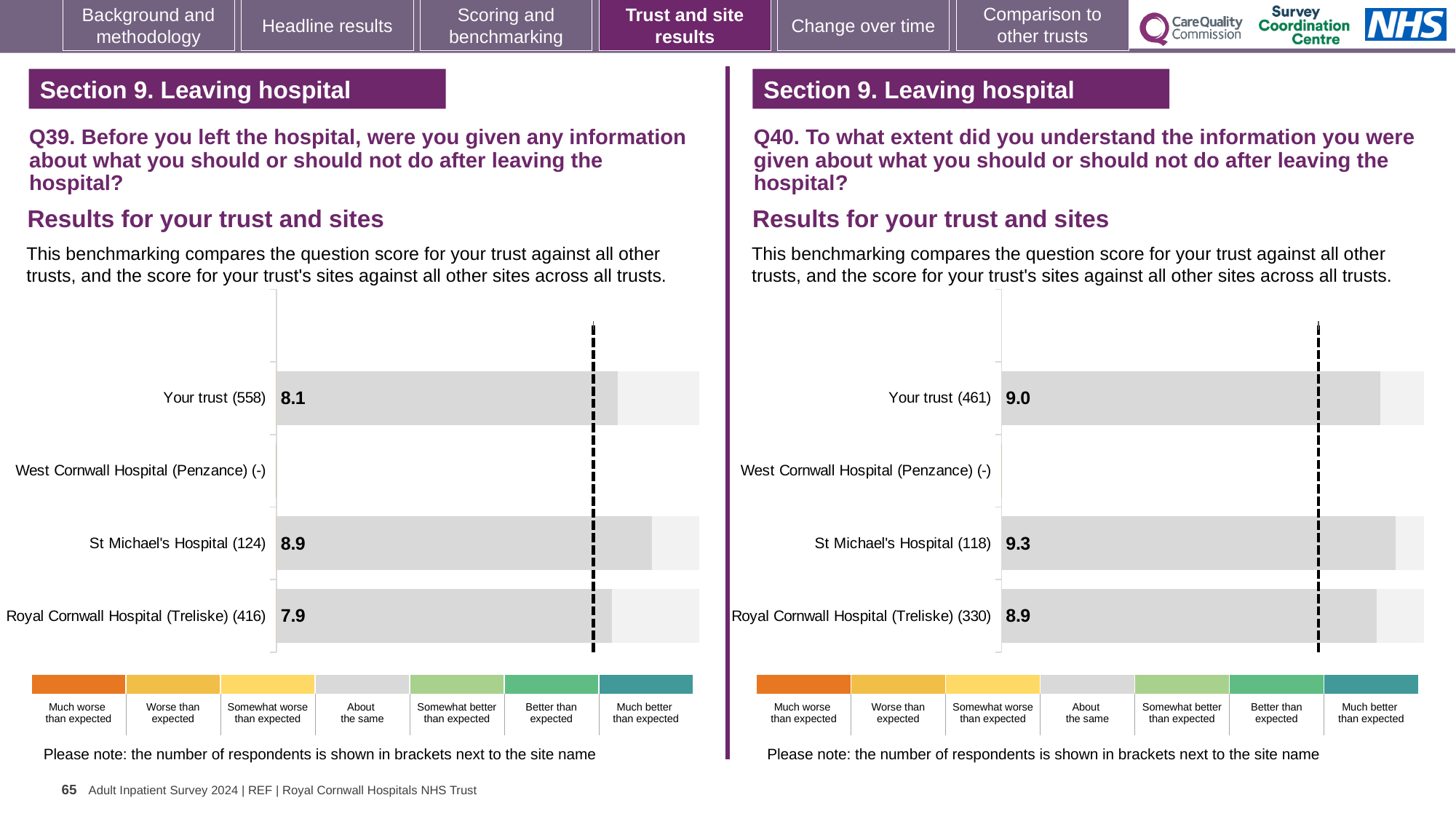
In the Q39 chart on the left, what is the score for Your trust? 8.1 How many rows (trust and sites) are listed on the y axis of the Q39 chart on the left? 4 In the Q39 chart on the left, what is the difference between the scores for St Michael's Hospital and Royal Cornwall Hospital (Treliske)? 1.0 In the Q40 chart on the right, which site or trust row has the highest score? St Michael's Hospital (118) In the Q40 chart on the right, which has the larger score: Your trust or Royal Cornwall Hospital (Treliske)? Your trust What kind of chart is used in the Q39 chart on the left? Bar chart In the Q40 chart on the right, what is the score for Your trust? 9.0 How many respondents are shown in brackets for Your trust in the Q40 chart on the right? 461 In the Q39 chart on the left, what is the score for Royal Cornwall Hospital (Treliske)? 7.9 In the Q40 chart on the right, what is the score for Royal Cornwall Hospital (Treliske)? 8.9 In the Q39 chart on the left, which row with a score shown has the lowest score? Royal Cornwall Hospital (Treliske) (416) In the Q39 chart on the left, what is the score for St Michael's Hospital? 8.9